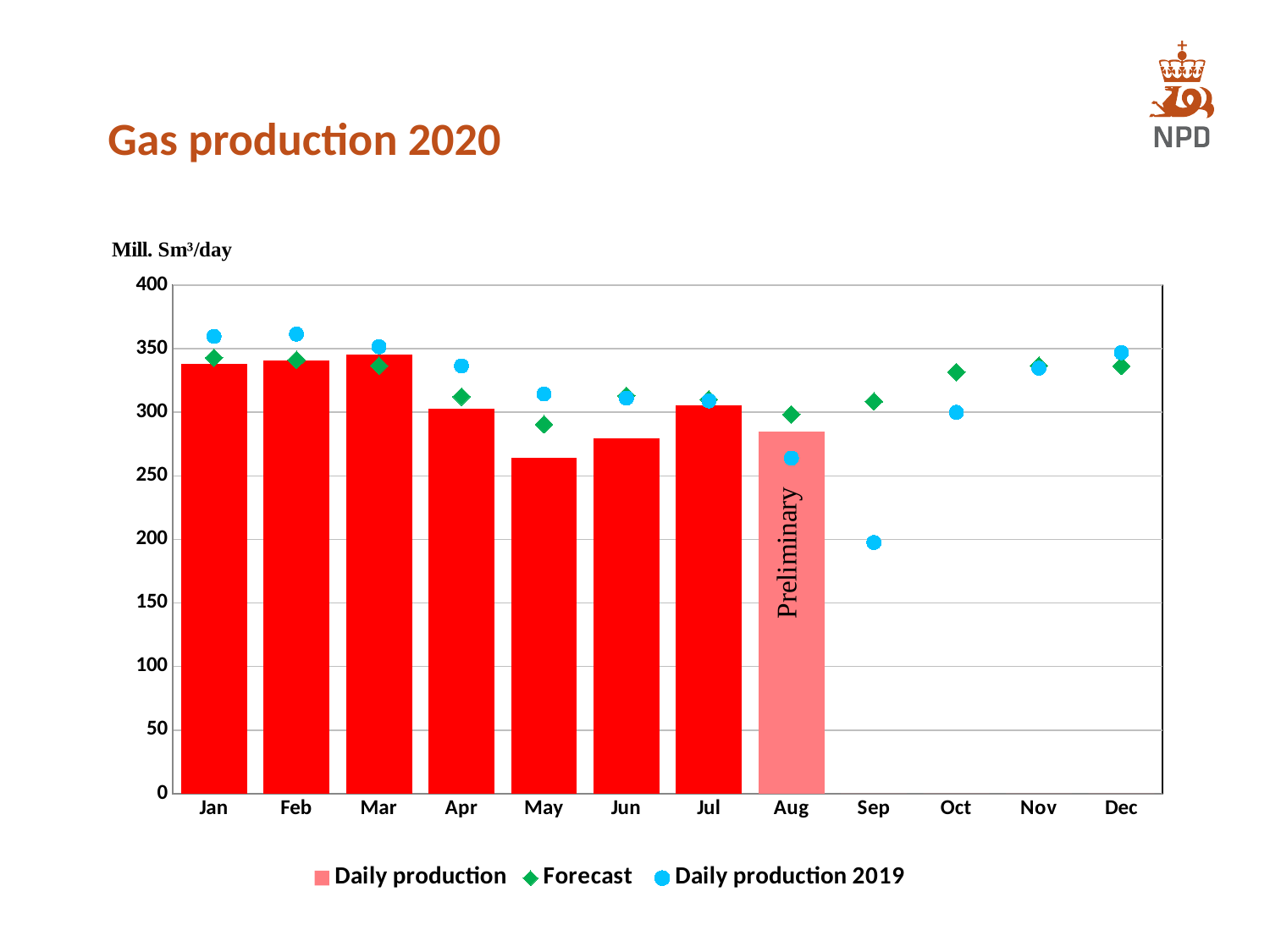
Is the Daily production 2019 value for Sep greater or less than 250? less How many months are shown on the x axis? 12 Is the Daily production value for May greater or less than 300? less Do the Daily production bars rise or fall from Mar to May? fall For how many months is a Daily production bar plotted? 8 Is the Daily production value for Jan greater or less than 300? greater Which month has the lowest Daily production 2019 value? Sep Which month has the lowest Daily production bar? May What kind of chart is shown on the slide? combination bar and line chart (bars with point markers) How many series does the legend list? 3 What label is written on the Aug bar? Preliminary Which is larger, the Daily production bar for Jun or for Jul? Jul